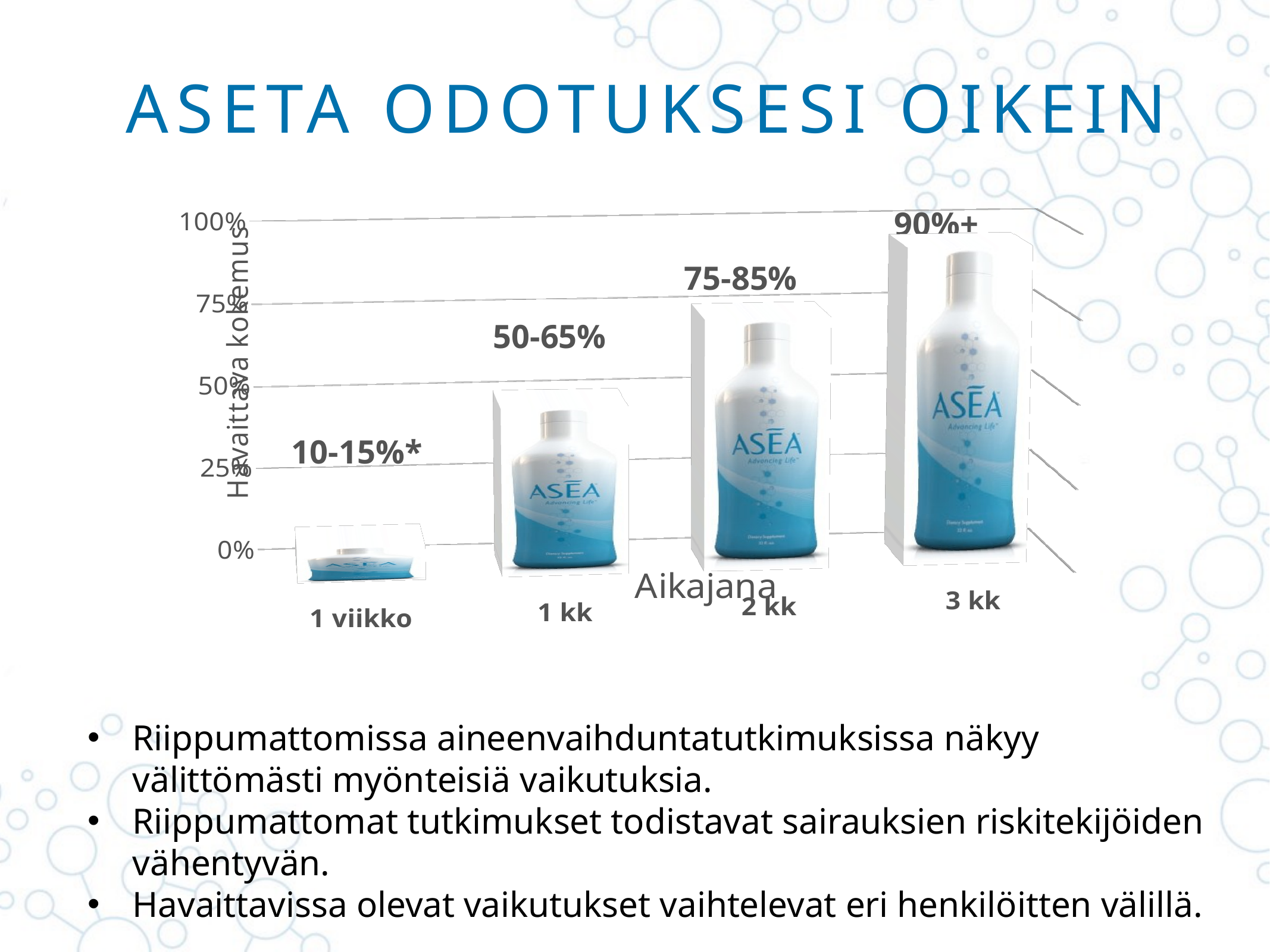
How many categories are shown on the x axis of the chart? 4 Which category has the highest value in the chart? 3 kk Which is larger, the value for 1 kk or the value for 3 kk? 3 kk Do the values rise or fall from 1 viikko to 3 kk along the x axis? rise What kind of chart is shown on the slide? bar chart What is the data label shown for the 3 kk category? 90%+ Is the value for 3 kk greater or less than 75%? greater Is the value for 1 viikko greater or less than 25%? less What is the data label shown for the 1 kk category? 50-65% What is the data label shown for the 1 viikko category? 10-15%* Which category has the lowest value in the chart? 1 viikko What is the data label shown for the 2 kk category? 75-85%